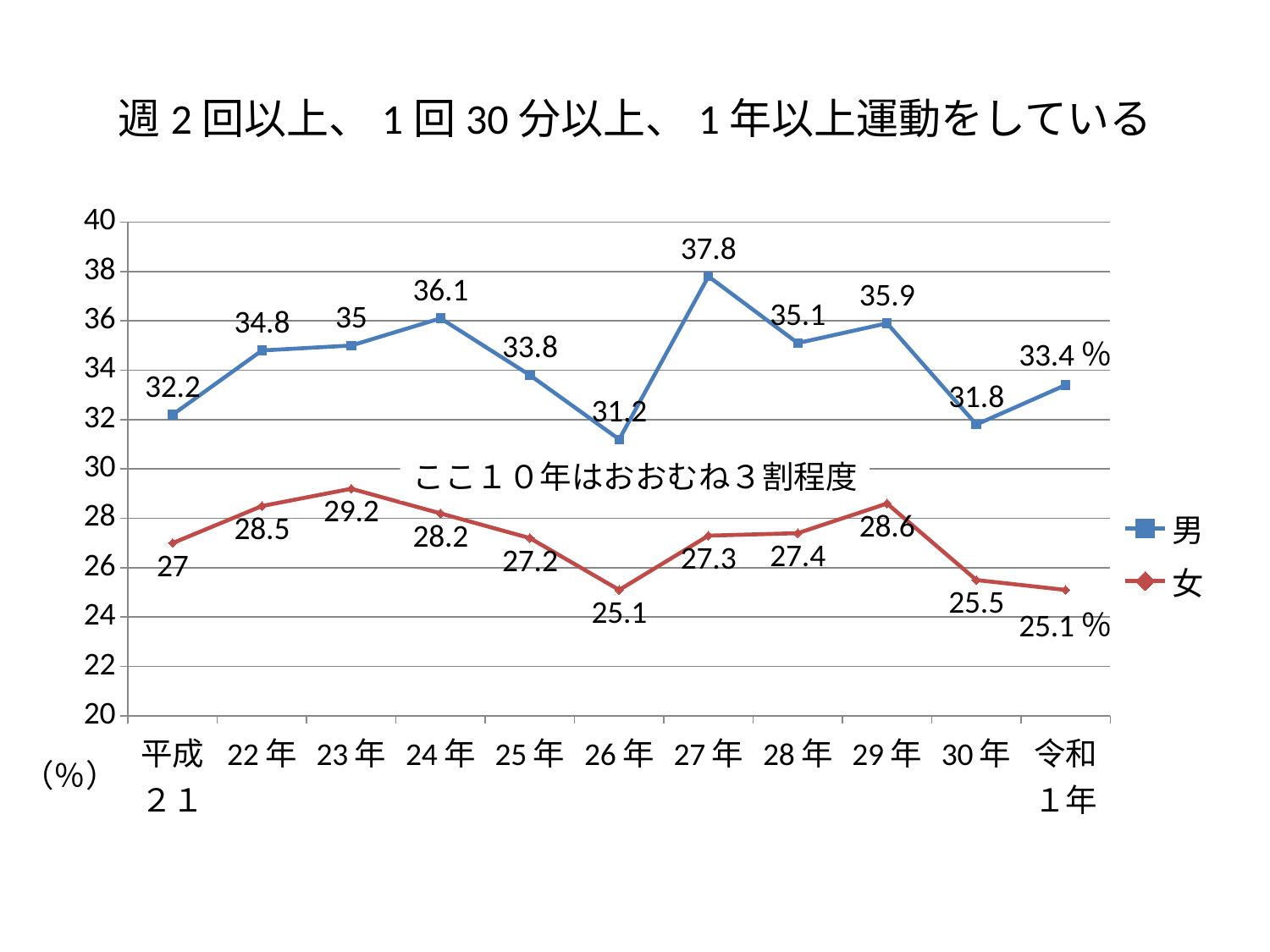
What type of chart is shown on the slide? line chart In which year is the value for 男 highest? 27年 How many series does the legend list? 2 What is the value for 男 in 27年? 37.8 What is the difference between the 男 values in 27年 and 26年? 6.6 How many years (categories) are plotted along the x axis? 11 What is the value for 男 in 平成21? 32.2 What is the value for 女 in 23年? 29.2 In which year is the value for 男 lowest? 26年 Which is larger, the 男 value in 24年 or in 25年? 24年 In which year is the value for 女 highest? 23年 What is the value for 女 in 30年? 25.5